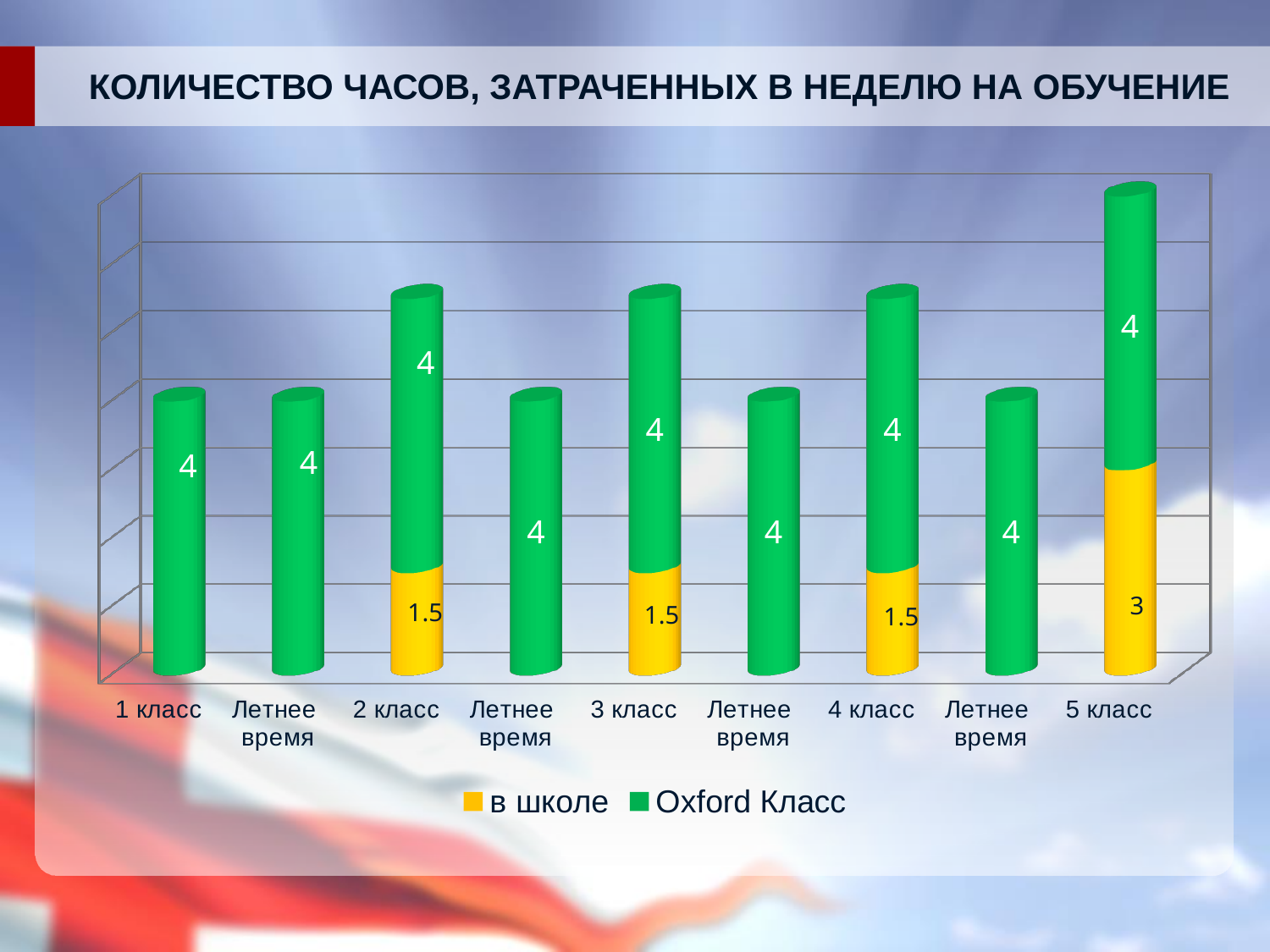
What is the total of the stacked bar for "5 класс"? 7 Which is larger: the "в школе" value for "5 класс" or the "в школе" value for "3 класс"? 5 класс What is the total of the stacked bar for "3 класс"? 5.5 What is the difference between the "в школе" value for "5 класс" and the "в школе" value for "4 класс"? 1.5 Which category has the tallest stacked bar? 5 класс What type of chart is shown on the slide? bar chart What is the title of the chart? КОЛИЧЕСТВО ЧАСОВ, ЗАТРАЧЕННЫХ В НЕДЕЛЮ НА ОБУЧЕНИЕ What is the value for "Oxford Класс" in the "1 класс" category? 4 How many categories are shown along the x axis? 9 What is the value for "в школе" in the "5 класс" category? 3 How many series does the legend list? 2 What is the value for "в школе" in the "2 класс" category? 1.5